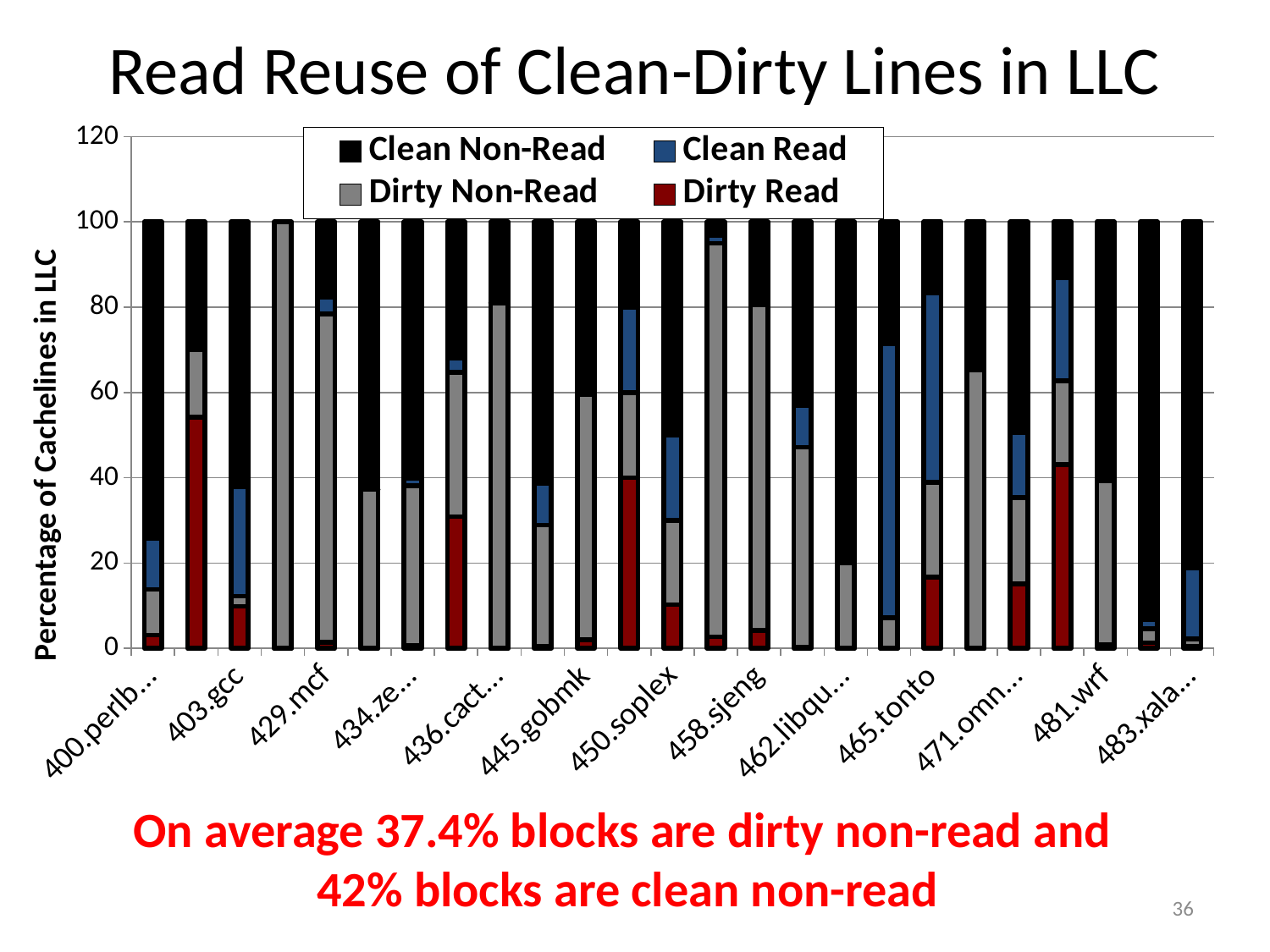
Is the Dirty Read value for 481.wrf greater or less than 20? less Is the Dirty Read value for 403.gcc greater or less than 20? less What is the total height of the stacked bar for 403.gcc? 100 What kind of chart is shown on the slide? bar chart Is the Clean Non-Read value for 458.sjeng greater or less than 80? less How many series does the legend list? 4 Which series is shown in red in the legend? Dirty Read Which is larger for 450.soplex, the Dirty Read segment or the Clean Non-Read segment? Clean Non-Read What is the title of the chart? Read Reuse of Clean-Dirty Lines in LLC According to the slide text, what percentage of blocks on average are clean non-read? 42%